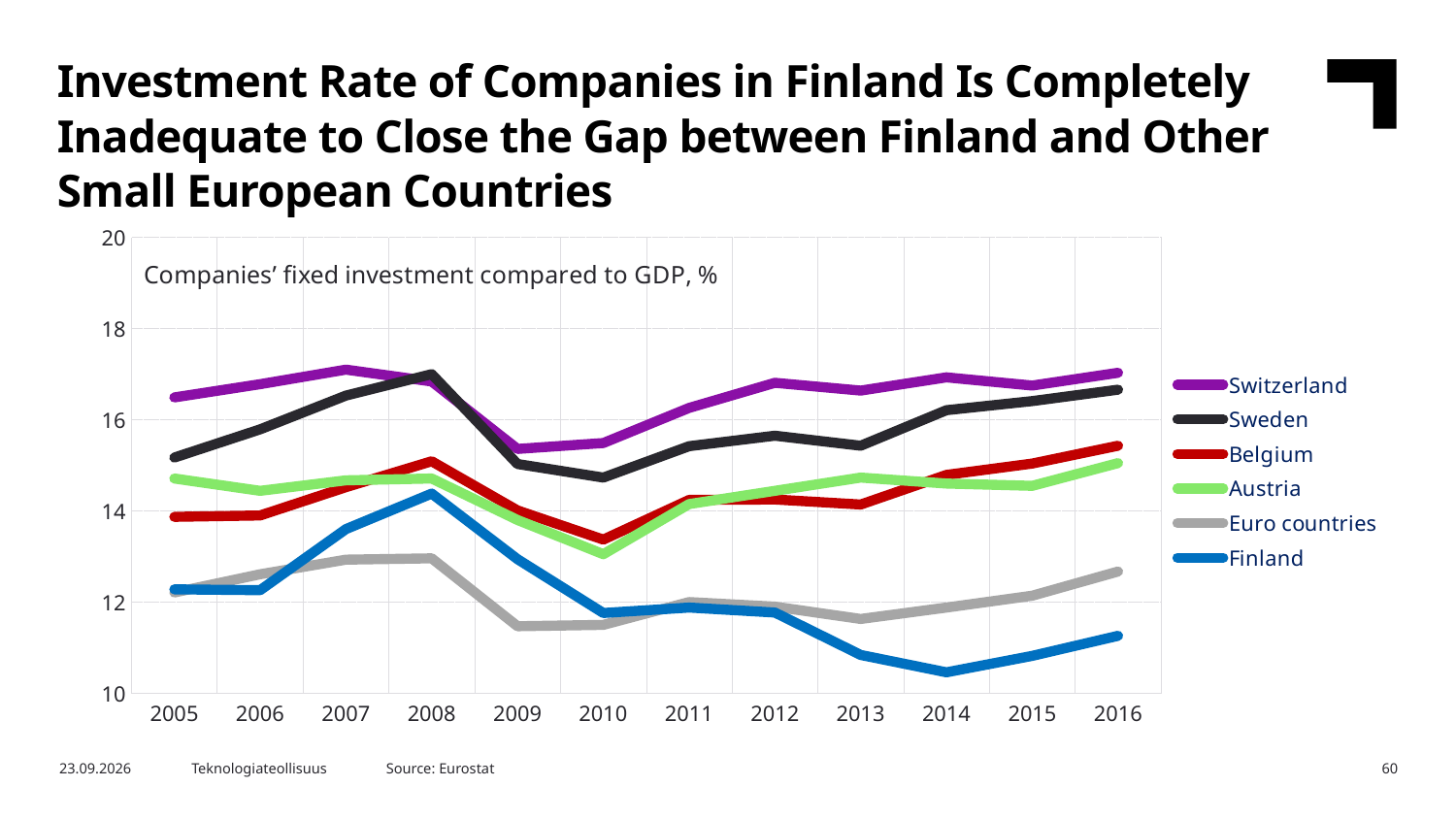
Is the value for Finland in 2014 greater or less than 12? less How many series does the legend list? 6 Is the value for Switzerland in 2007 greater or less than 16? greater Which country or group has the lowest value in 2016? Finland How many years are shown on the x axis? 12 In which year does Finland reach its highest value? 2008 Which country or group has the highest value in 2016? Switzerland What is the subtitle text shown inside the chart area? Companies' fixed investment compared to GDP, % Which is larger for Finland: the value in 2008 or the value in 2014? 2008 What type of chart is shown on the slide? Line chart Is the value for Sweden in 2010 greater or less than 16? less Does the Finland line rise or fall from 2008 to 2014? Fall